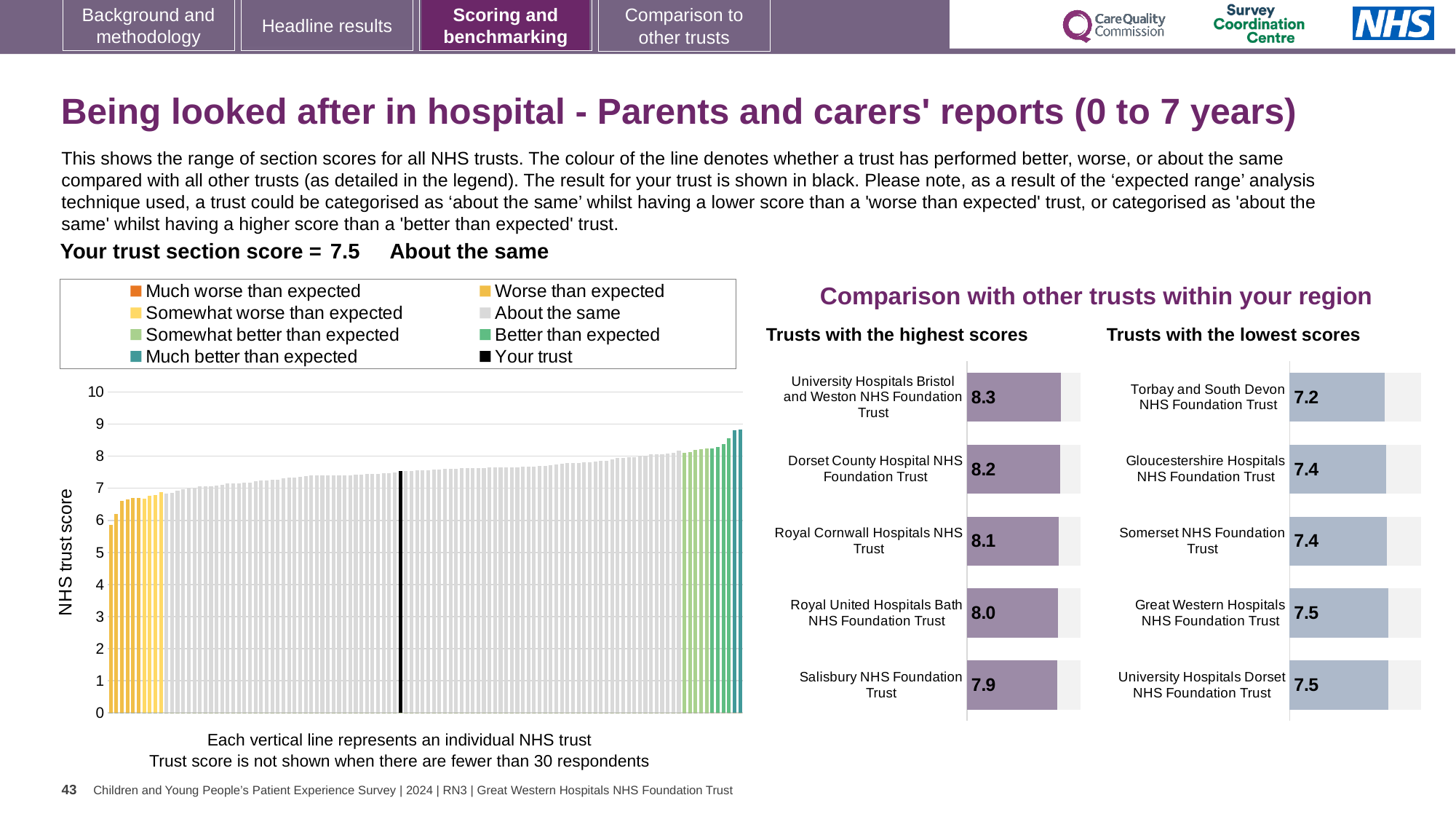
In the 'Trusts with the highest scores' chart, which has the larger score: Dorset County Hospital NHS Foundation Trust or Royal Cornwall Hospitals NHS Trust? Dorset County Hospital NHS Foundation Trust In the large chart on the left, do the bar heights rise or fall from left to right? rise In the large chart on the left, is the value of the tallest bar greater or less than 8? greater In the 'Trusts with the lowest scores' chart, what is the score for Torbay and South Devon NHS Foundation Trust? 7.2 In the large chart on the left, what is the label on the vertical axis? NHS trust score What kind of chart is the large chart on the left of the slide? bar chart How many trusts are shown in the 'Trusts with the lowest scores' chart? 5 In the 'Trusts with the highest scores' chart, what is the difference between the scores of University Hospitals Bristol and Weston NHS Foundation Trust and Salisbury NHS Foundation Trust? 0.4 In the 'Trusts with the highest scores' chart, what is the score for University Hospitals Bristol and Weston NHS Foundation Trust? 8.3 In the 'Trusts with the highest scores' chart, which trust has the lowest score? Salisbury NHS Foundation Trust In the 'Trusts with the lowest scores' chart, what is the difference between the scores of Great Western Hospitals NHS Foundation Trust and Torbay and South Devon NHS Foundation Trust? 0.3 How many entries does the legend above the large chart on the left list? 8